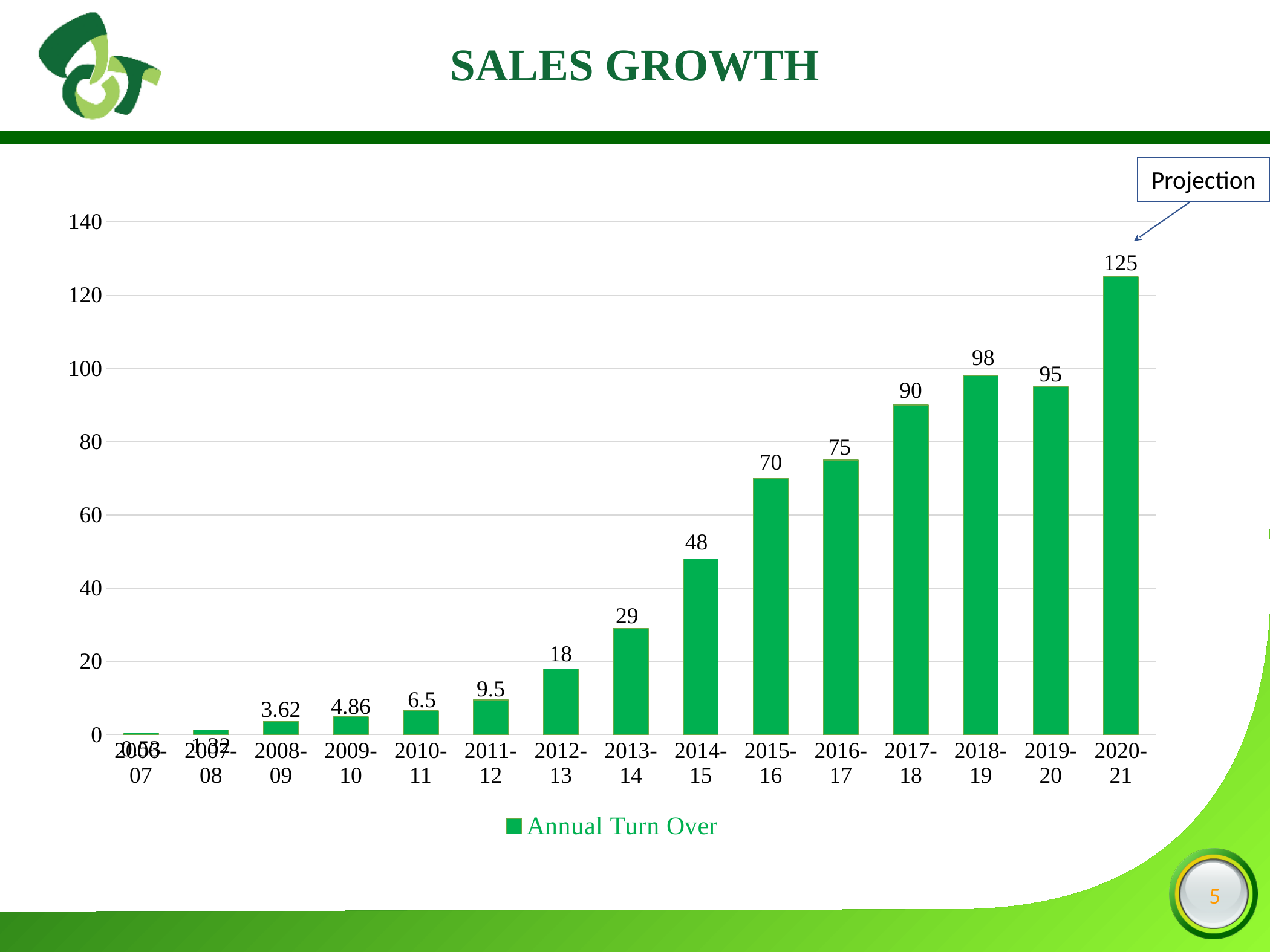
How many years are shown on the x axis of the chart? 15 What is the Annual Turn Over value for 2010-11? 6.5 How many series does the legend list? 1 Which is larger, the Annual Turn Over for 2018-19 or for 2019-20? 2018-19 What is the Annual Turn Over value for 2020-21? 125 What is the difference between the Annual Turn Over for 2018-19 and 2019-20? 3 What is the Annual Turn Over value for 2014-15? 48 What is the difference between the Annual Turn Over for 2016-17 and 2015-16? 5 What kind of chart is shown on the slide? bar chart What is the name of the series shown in the legend? Annual Turn Over Which year has the highest Annual Turn Over? 2020-21 Do the Annual Turn Over values generally rise or fall from 2006-07 to 2020-21? rise